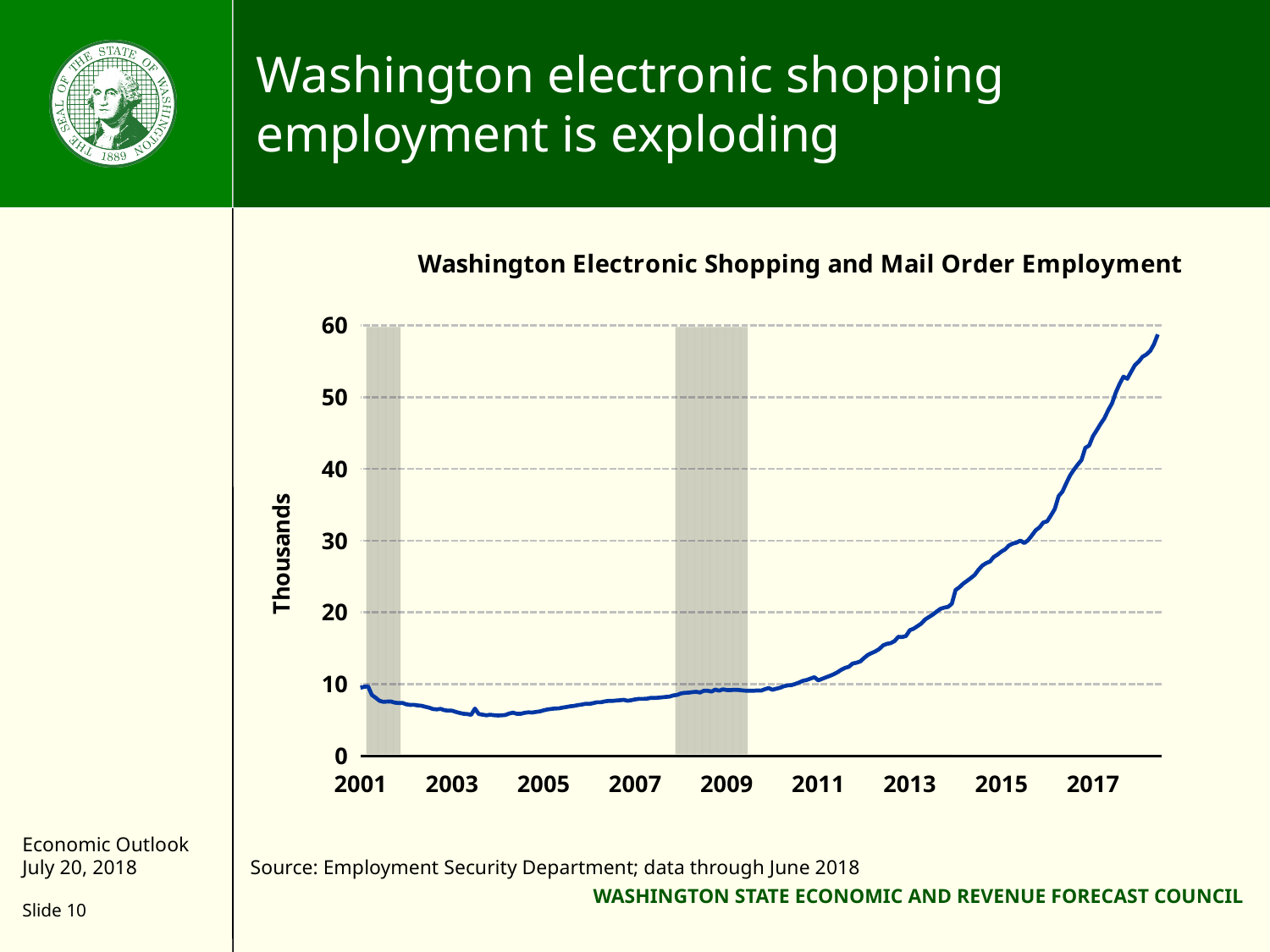
Is the value at 2013 greater or less than 20? less What is the label on the vertical axis of the chart? Thousands What is the title of the chart? Washington Electronic Shopping and Mail Order Employment Which is higher, the value at 2017 or the value at 2005? 2017 Is the value at 2017 greater or less than 30? greater Is the value at 2015 greater or less than 20? greater What kind of chart is shown on the slide? line chart Does the line rise or fall between 2013 and 2017? rise Does the line rise or fall between 2001 and 2003? fall How many year labels are shown along the x axis? 9